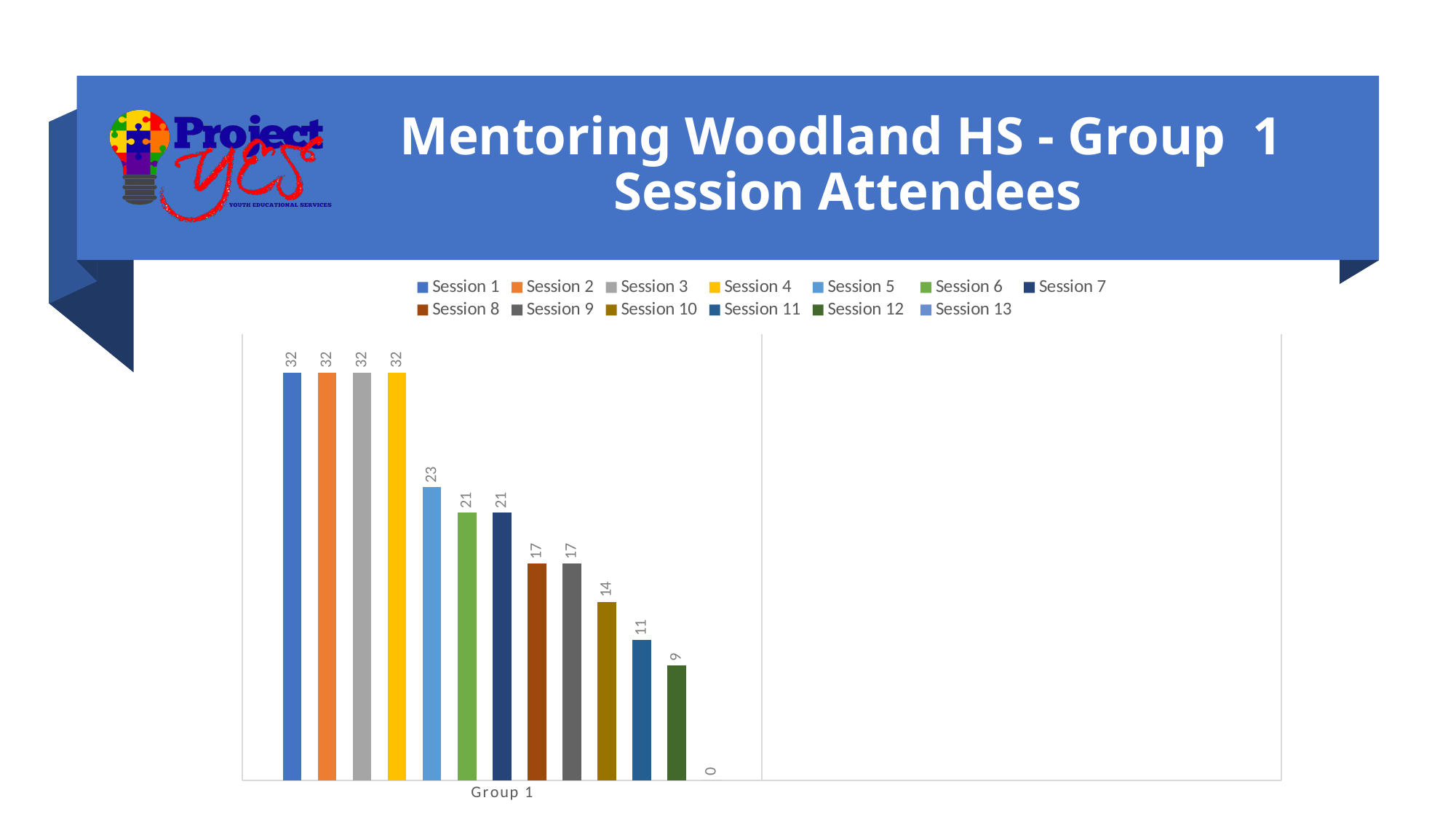
What is the value for Session 13? 0 Do the values rise or fall from Session 1 to Session 13? Fall What is the difference between the values for Session 5 and Session 8? 6 How many series does the legend list? 13 What is the value for Session 12? 9 What kind of chart is shown on the slide? Bar chart Which session has the lowest number of attendees? Session 13 What is the value for Session 10? 14 What is the category label shown on the x axis? Group 1 What is the difference between the values for Session 1 and Session 11? 21 Which is larger, the value for Session 6 or the value for Session 9? Session 6 What is the value for Session 5? 23